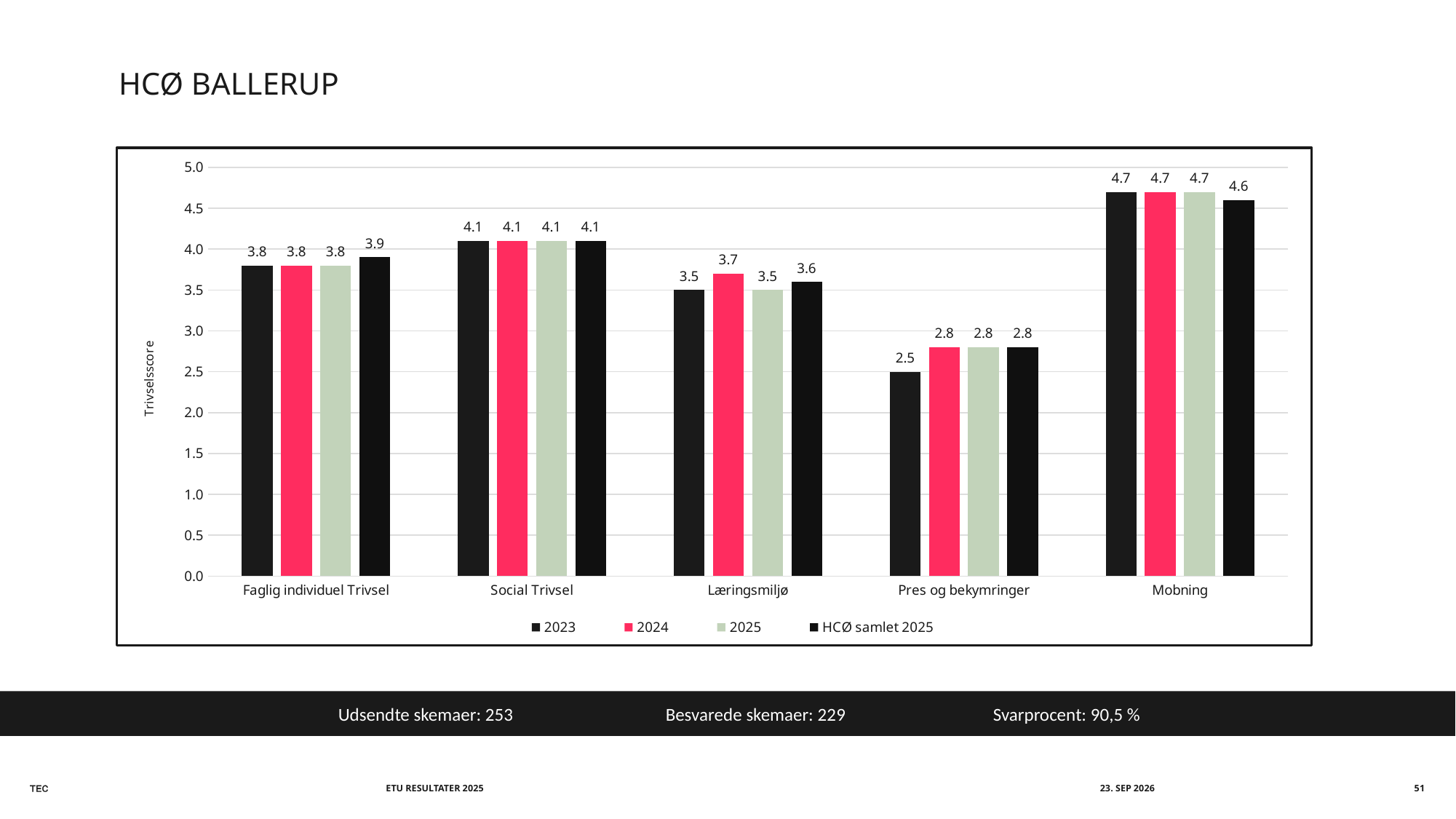
What is the 2024 value for Læringsmiljø? 3.7 What kind of chart is shown on the slide? Bar chart Which category has the lowest 2025 value? Pres og bekymringer Which is larger for Mobning: the 2025 value or the HCØ samlet 2025 value? 2025 What is the HCØ samlet 2025 value for Faglig individuel Trivsel? 3.9 What is the 2025 value for Mobning? 4.7 What is the label of the y axis? Trivselsscore Which category has the highest 2023 value? Mobning What is the difference between the 2024 and 2023 values for Pres og bekymringer? 0.3 How many categories are shown on the x axis? 5 How many series does the legend list? 4 What is the 2023 value for Pres og bekymringer? 2.5